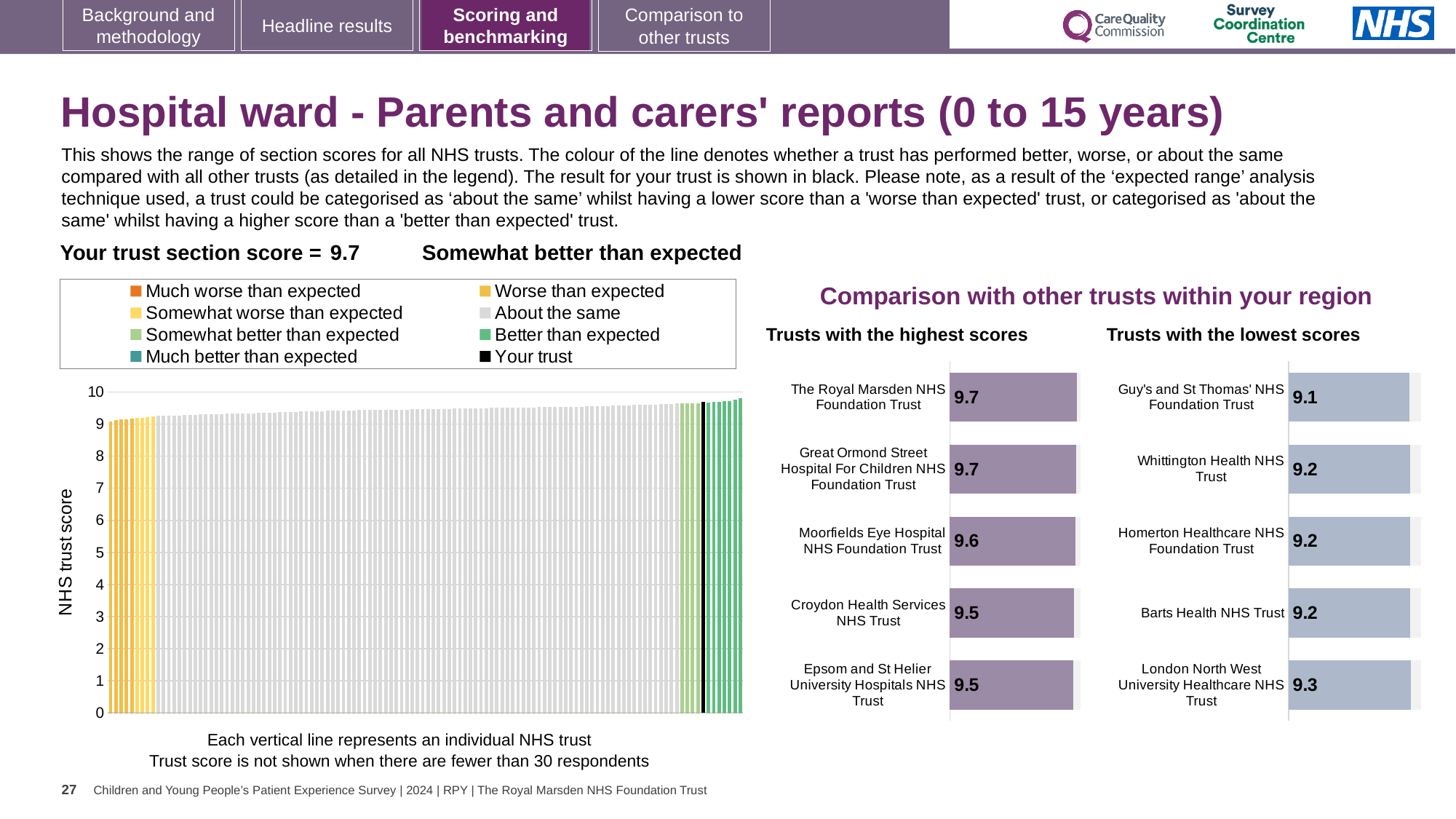
What kind of chart is the 'NHS trust score' chart on the left of the slide? Bar chart In the 'Trusts with the lowest scores' chart, what is the score for Guy's and St Thomas' NHS Foundation Trust? 9.1 How many entries does the legend of the 'NHS trust score' chart on the left list? 8 In the 'Trusts with the highest scores' chart, which has the larger score: Moorfields Eye Hospital NHS Foundation Trust or Croydon Health Services NHS Trust? Moorfields Eye Hospital NHS Foundation Trust In the 'Trusts with the highest scores' chart, what is the score for Moorfields Eye Hospital NHS Foundation Trust? 9.6 In the 'NHS trust score' chart on the left, are the yellow 'Worse than expected' bars greater or less than 8? greater How many trusts are shown in the 'Trusts with the lowest scores' chart? 5 What is the y-axis label of the chart on the left of the slide? NHS trust score In the 'Trusts with the lowest scores' chart, which trust has the lowest score? Guy's and St Thomas' NHS Foundation Trust How many trusts are shown in the 'Trusts with the highest scores' chart? 5 In the 'Trusts with the lowest scores' chart, which trust has the highest score? London North West University Healthcare NHS Trust What is the difference between the score for The Royal Marsden NHS Foundation Trust in the 'Trusts with the highest scores' chart and the score for Guy's and St Thomas' NHS Foundation Trust in the 'Trusts with the lowest scores' chart? 0.6